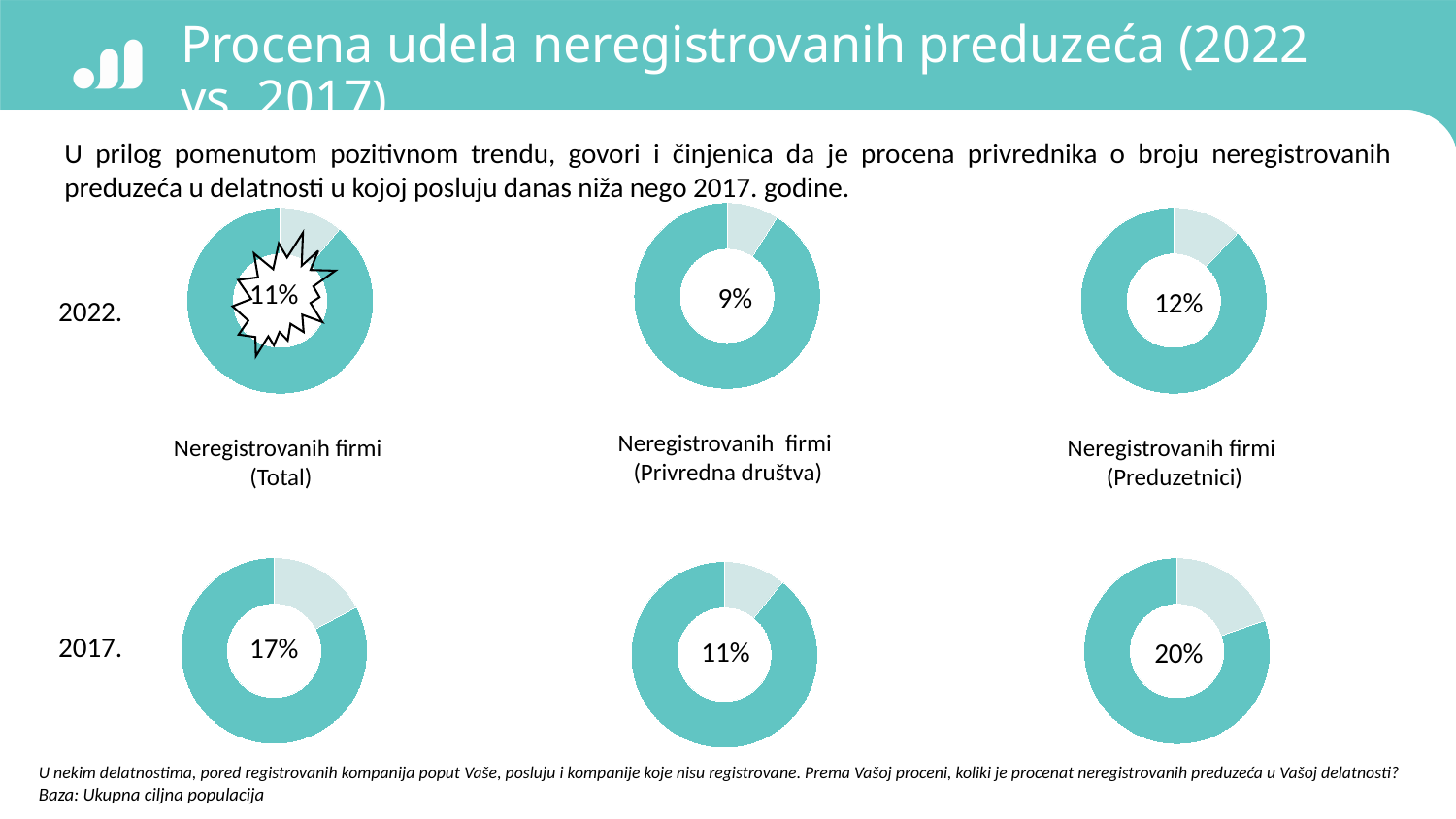
Among the three 2022 donut charts, which category has the lowest value? Neregistrovanih firmi (Privredna društva) For 'Neregistrovanih firmi (Total)', what is the difference between the 2017 value and the 2022 value? 6 percentage points What type of chart is used to show the values on this slide? Donut (pie) chart In the 2022 row, what value is shown in the 'Neregistrovanih firmi (Privredna društva)' donut chart? 9% In the 2017 row, what value is shown in the 'Neregistrovanih firmi (Total)' donut chart? 17% Which is larger: the 2022 value for 'Neregistrovanih firmi (Privredna društva)' or the 2022 value for 'Neregistrovanih firmi (Preduzetnici)'? Neregistrovanih firmi (Preduzetnici) Among the three 2017 donut charts, which category has the highest value? Neregistrovanih firmi (Preduzetnici) For 'Neregistrovanih firmi (Preduzetnici)', what is the difference between the 2017 value and the 2022 value? 8 percentage points In the 2022 row, what value is shown in the 'Neregistrovanih firmi (Preduzetnici)' donut chart? 12% In the 2017 row, what value is shown in the 'Neregistrovanih firmi (Preduzetnici)' donut chart? 20% In the 2022 row, what value is shown in the centre of the 'Neregistrovanih firmi (Total)' donut chart? 11% In the 2017 row, what value is shown in the 'Neregistrovanih firmi (Privredna društva)' donut chart? 11%